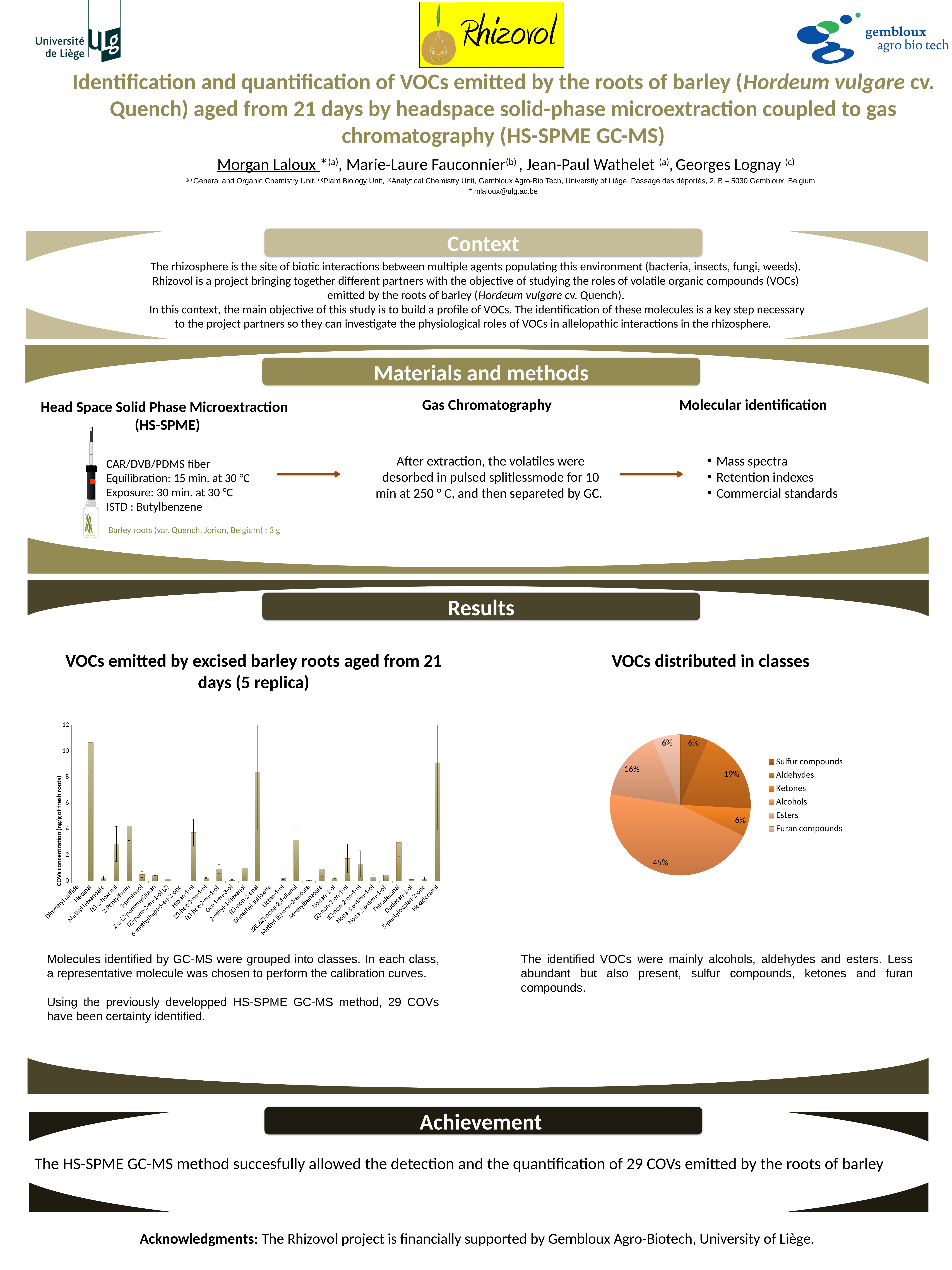
In the 'VOCs distributed in classes' pie chart, what percentage is shown for Esters? 16% In the 'VOCs distributed in classes' pie chart, which class has the largest share? Alcohols In the 'VOCs distributed in classes' pie chart, what percentage is shown for Aldehydes? 19% What kind of chart is 'VOCs distributed in classes'? Pie chart In the 'VOCs emitted by excised barley roots' bar chart, is the value for Hexan-1-ol greater or less than 4? less In the 'VOCs distributed in classes' pie chart, what share do Alcohols represent? 45% In the 'VOCs emitted by excised barley roots' bar chart, which has the higher concentration, Hexadecanal or Tetradecanal? Hexadecanal In the 'VOCs emitted by excised barley roots' bar chart, is the value for Hexanal greater or less than 10? greater How many classes are listed in the legend of the 'VOCs distributed in classes' chart? 6 In the 'VOCs emitted by excised barley roots' bar chart, which compound has the highest concentration? Hexanal What kind of chart is 'VOCs emitted by excised barley roots aged from 21 days (5 replica)'? Bar chart In the 'VOCs distributed in classes' pie chart, what is the difference in percentage points between Alcohols and Aldehydes? 26%